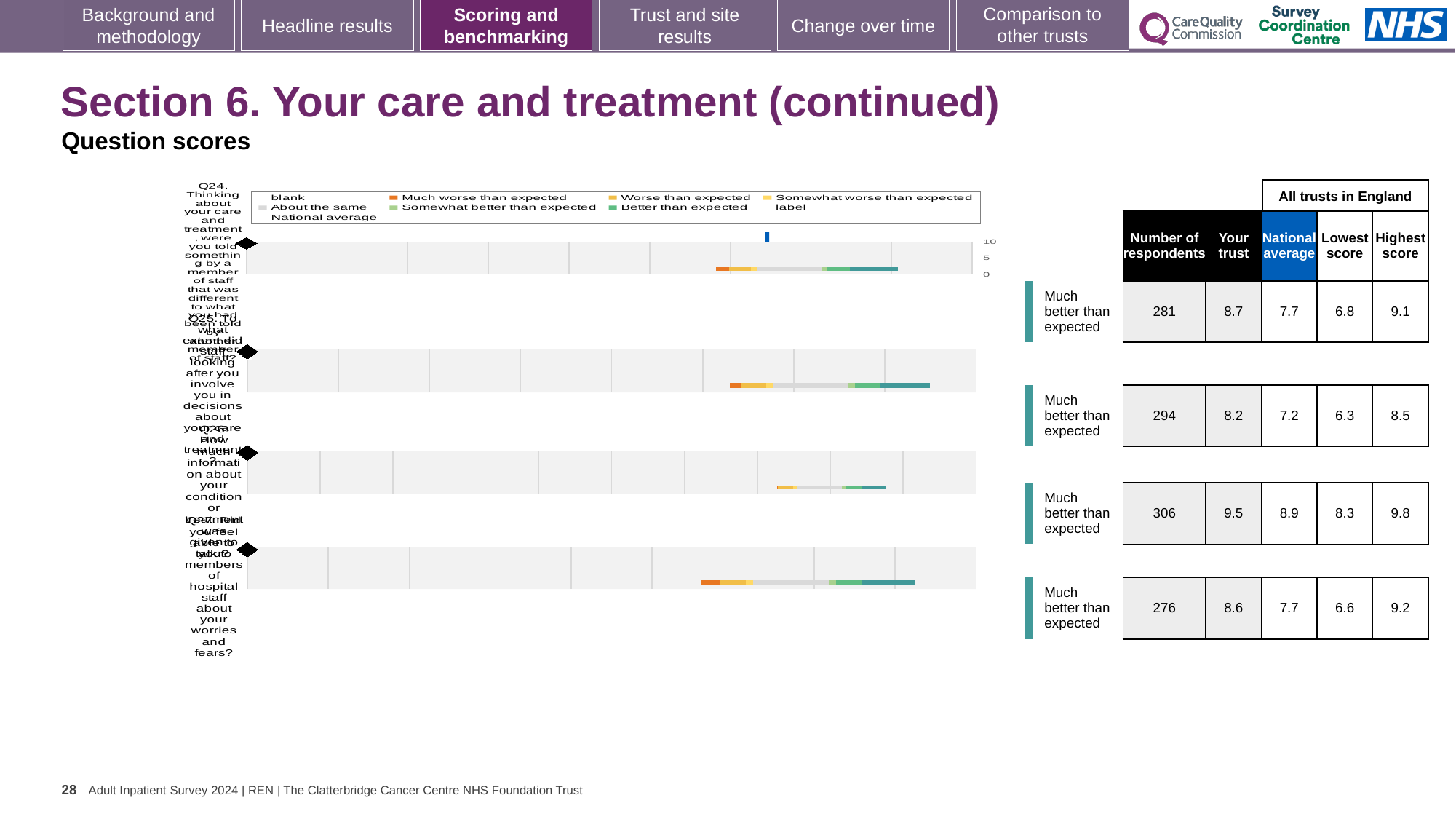
Which question has the highest 'Your trust' score in the table: Q24, Q25, Q26 or Q27? Q26 In the table next to the Q24 chart, what is the 'Your trust' score? 8.7 What kind of chart is used for the Q24 question score? bar chart In the table next to the Q26 chart, what is the 'Your trust' score? 9.5 Which legend entry is shown in the darkest orange colour on the charts? Much worse than expected How many question-score charts are shown on the slide? 4 In the table next to the Q27 chart, how many respondents are listed? 276 In the table next to the Q25 chart, what is the national average? 7.2 What is the difference between the 'Your trust' score and the national average for Q26 in the table? 0.6 What is the highest value shown on the x axis of the Q24 chart? 10